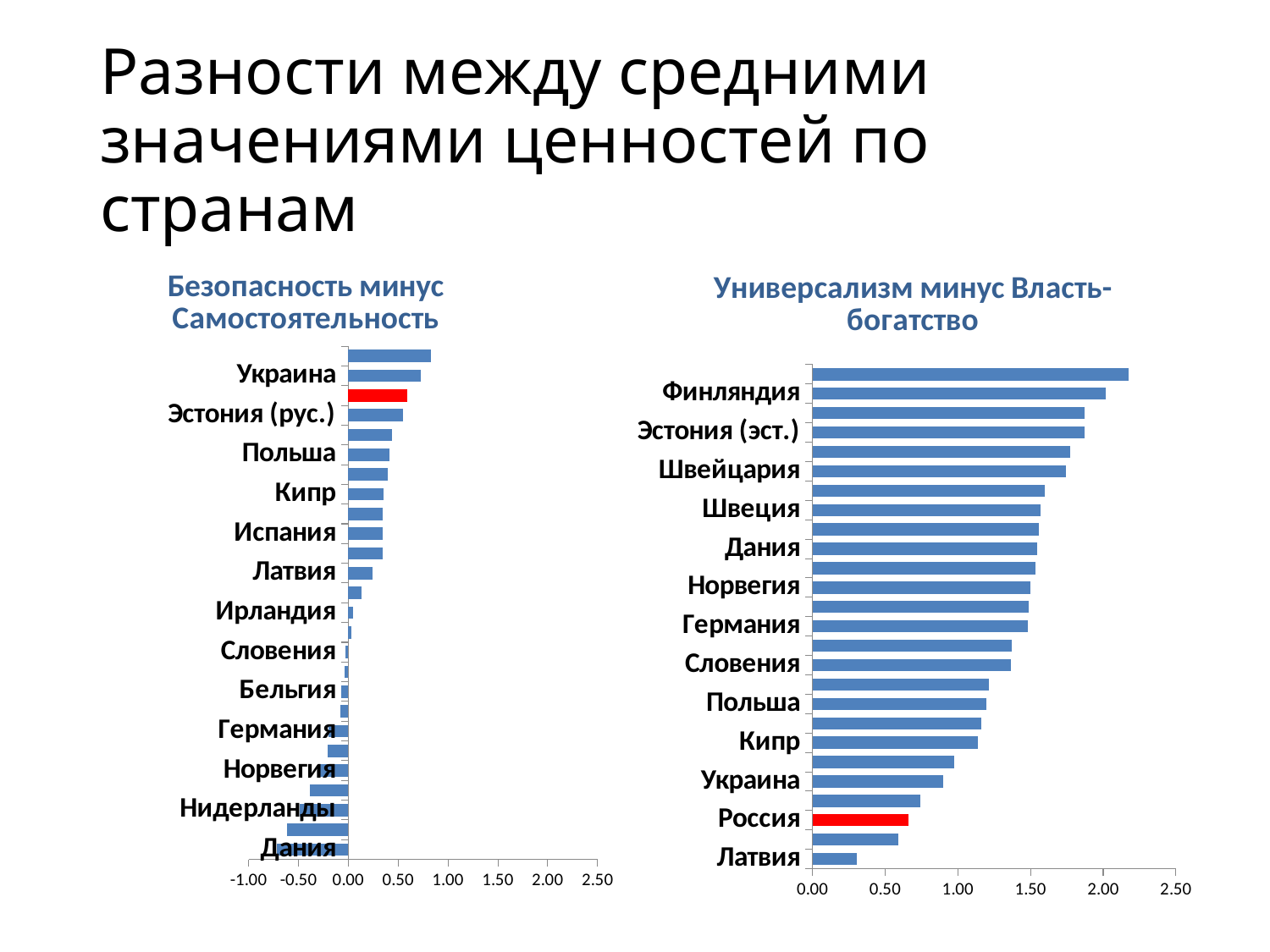
In the chart titled "Безопасность минус Самостоятельность", is the value for Дания greater or less than 0.00? less In the chart titled "Универсализм минус Власть-богатство", what colour is the bar for Россия? red In the chart titled "Универсализм минус Власть-богатство", which labeled country has the lowest value? Латвия What kind of chart is used on this slide for both charts? bar chart In the chart titled "Безопасность минус Самостоятельность", is the value for Украина greater or less than 0.50? greater In the chart titled "Универсализм минус Власть-богатство", is the value for Латвия greater or less than 0.50? less In the chart titled "Универсализм минус Власть-богатство", which has the larger value, Финляндия or Латвия? Финляндия In the chart titled "Безопасность минус Самостоятельность", which has the larger value, Украина or Дания? Украина